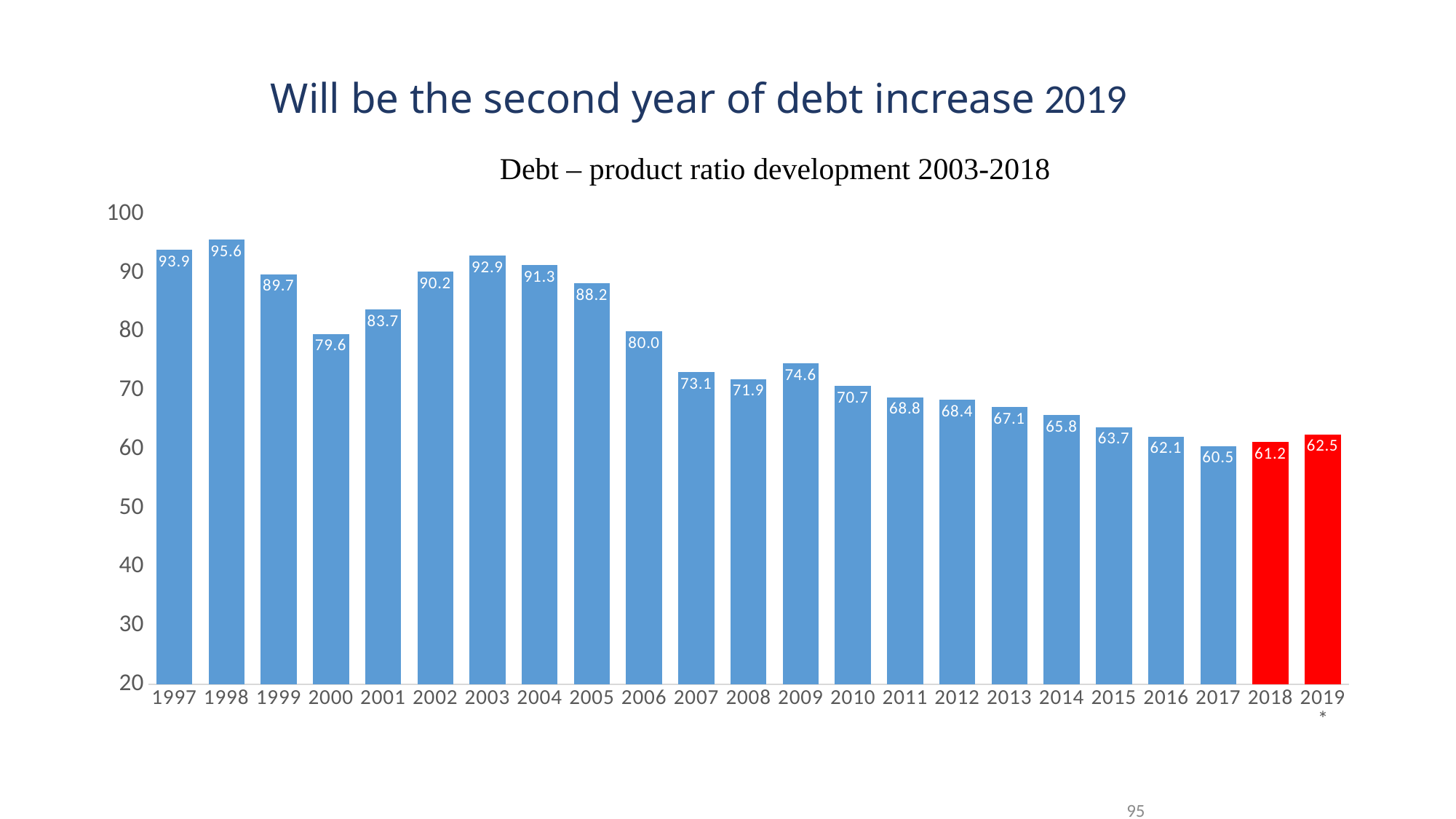
Which is larger, the value for 2009 or the value for 2008? 2009 What is the difference between the values for 2019 and 2018? 1.3 What is the difference between the values for 1998 and 2000? 16 What is the debt-product ratio value for 2003? 92.9 What is the value shown for 2019? 62.5 What kind of chart is shown on the slide? bar chart How many years are shown on the x axis? 23 Which year has the lowest value in the chart? 2017 Is the value for 2006 greater or less than 70? greater Which year has the highest value in the chart? 1998 What is the value shown for 2017? 60.5 Which bars are coloured red instead of blue? 2018 and 2019